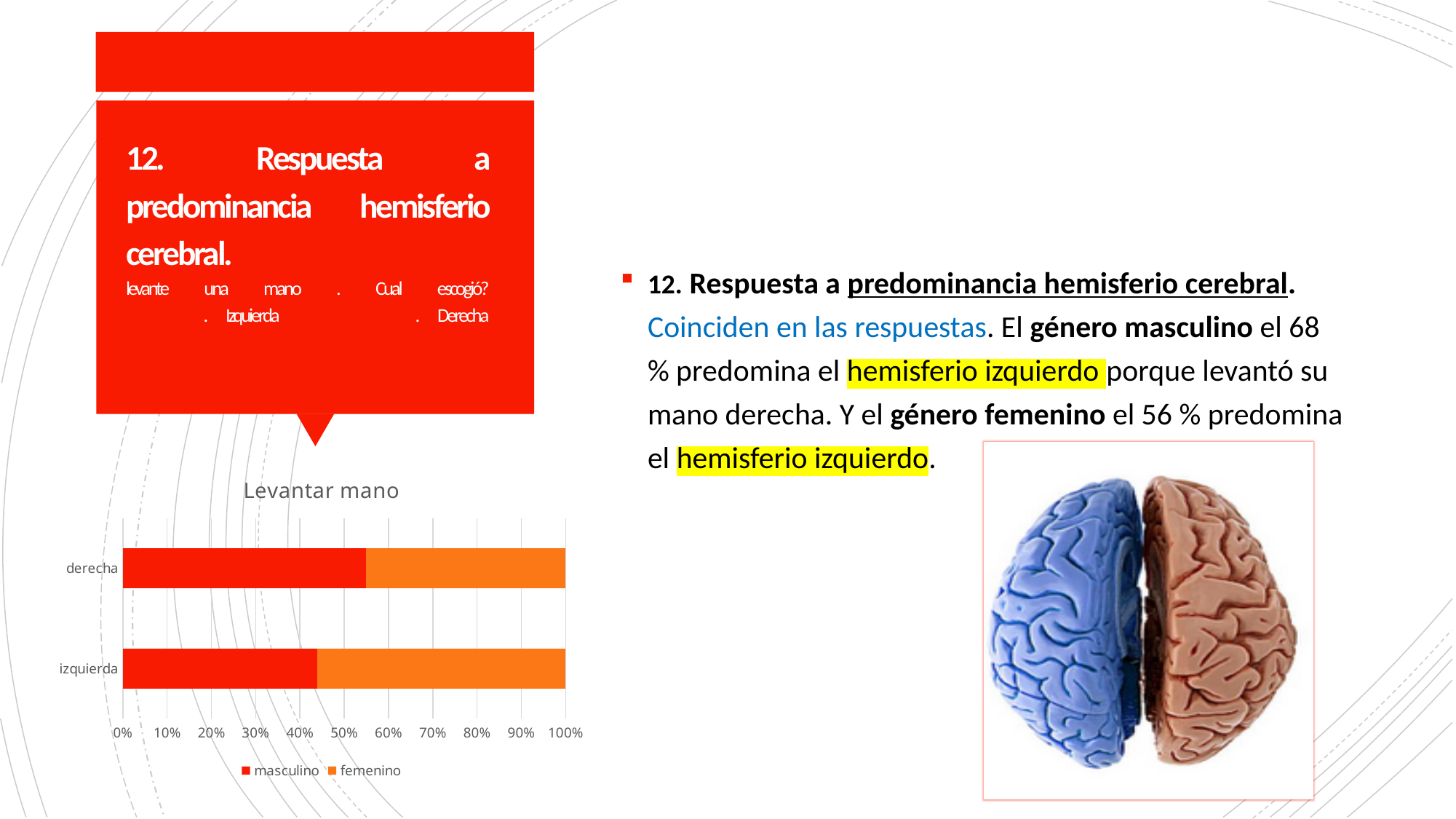
Which category has the larger femenino share, derecha or izquierda? izquierda Is the masculino value for izquierda greater or less than 50%? less What is the title of the chart on the slide? Levantar mano Which category has the larger masculino share, derecha or izquierda? derecha What is the maximum value shown on the chart's horizontal axis? 100% Is the masculino value for derecha greater or less than 70%? less How many series does the chart legend list? 2 Is the masculino value for derecha greater or less than 50%? greater What kind of chart is shown on the slide? bar chart How many categories are shown on the chart's vertical axis? 2 Which series are listed in the chart legend? masculino, femenino